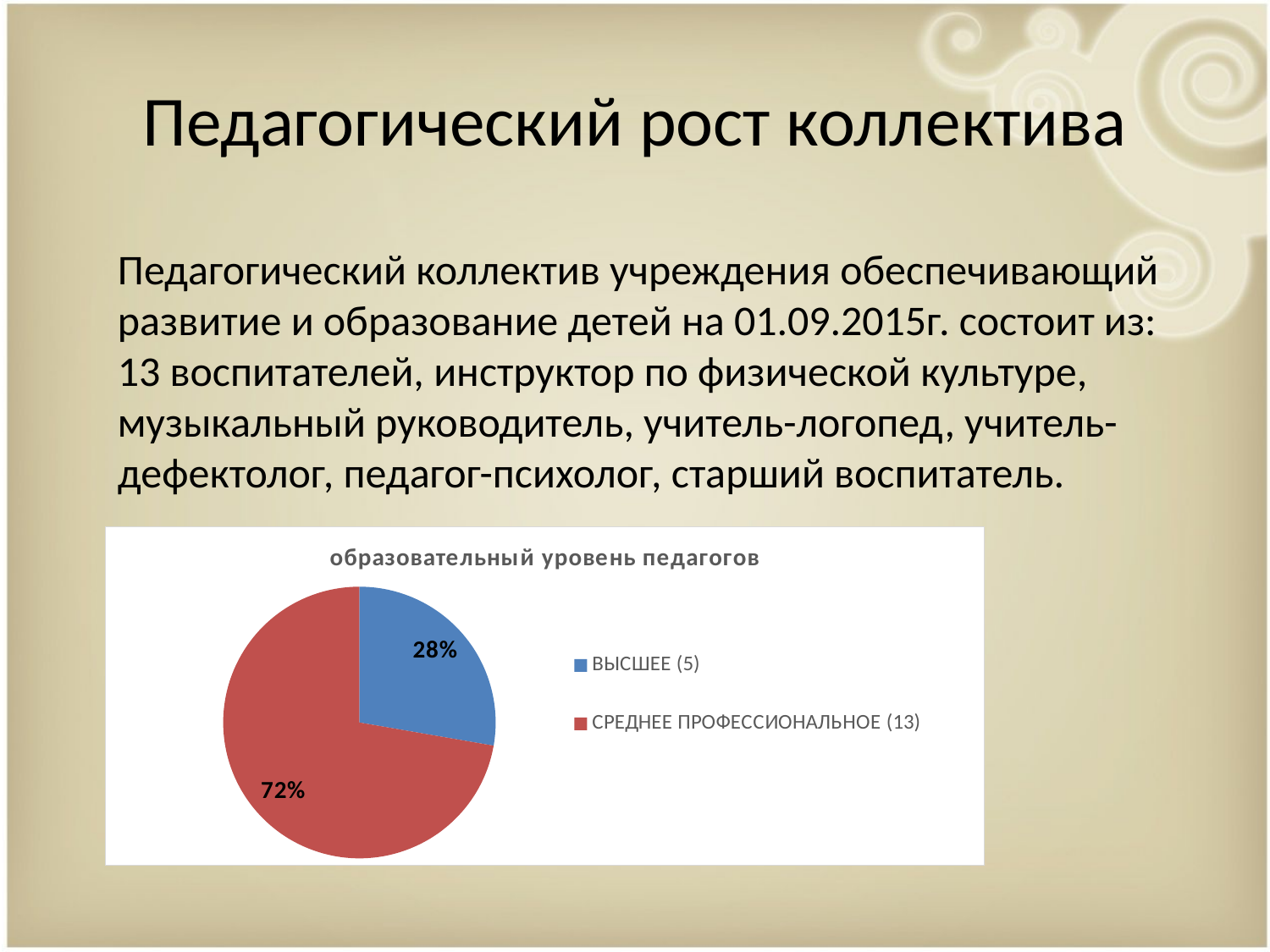
How many categories does the pie chart have? 2 Which slice is larger, ВЫСШЕЕ (5) or СРЕДНЕЕ ПРОФЕССИОНАЛЬНОЕ (13)? СРЕДНЕЕ ПРОФЕССИОНАЛЬНОЕ (13) What share of the pie does СРЕДНЕЕ ПРОФЕССИОНАЛЬНОЕ (13) take? 72% What share of the pie does ВЫСШЕЕ (5) take? 28% How many entries does the legend list? 2 Which category has the largest slice of the pie? СРЕДНЕЕ ПРОФЕССИОНАЛЬНОЕ (13) What colour is the slice for ВЫСШЕЕ (5)? blue Which category has the smallest slice of the pie? ВЫСШЕЕ (5) What is the difference in percentage points between the СРЕДНЕЕ ПРОФЕССИОНАЛЬНОЕ (13) slice and the ВЫСШЕЕ (5) slice? 44% What is the title of the chart? образовательный уровень педагогов Is the share for ВЫСШЕЕ (5) greater or less than 50%? less What kind of chart is shown on the slide? pie chart